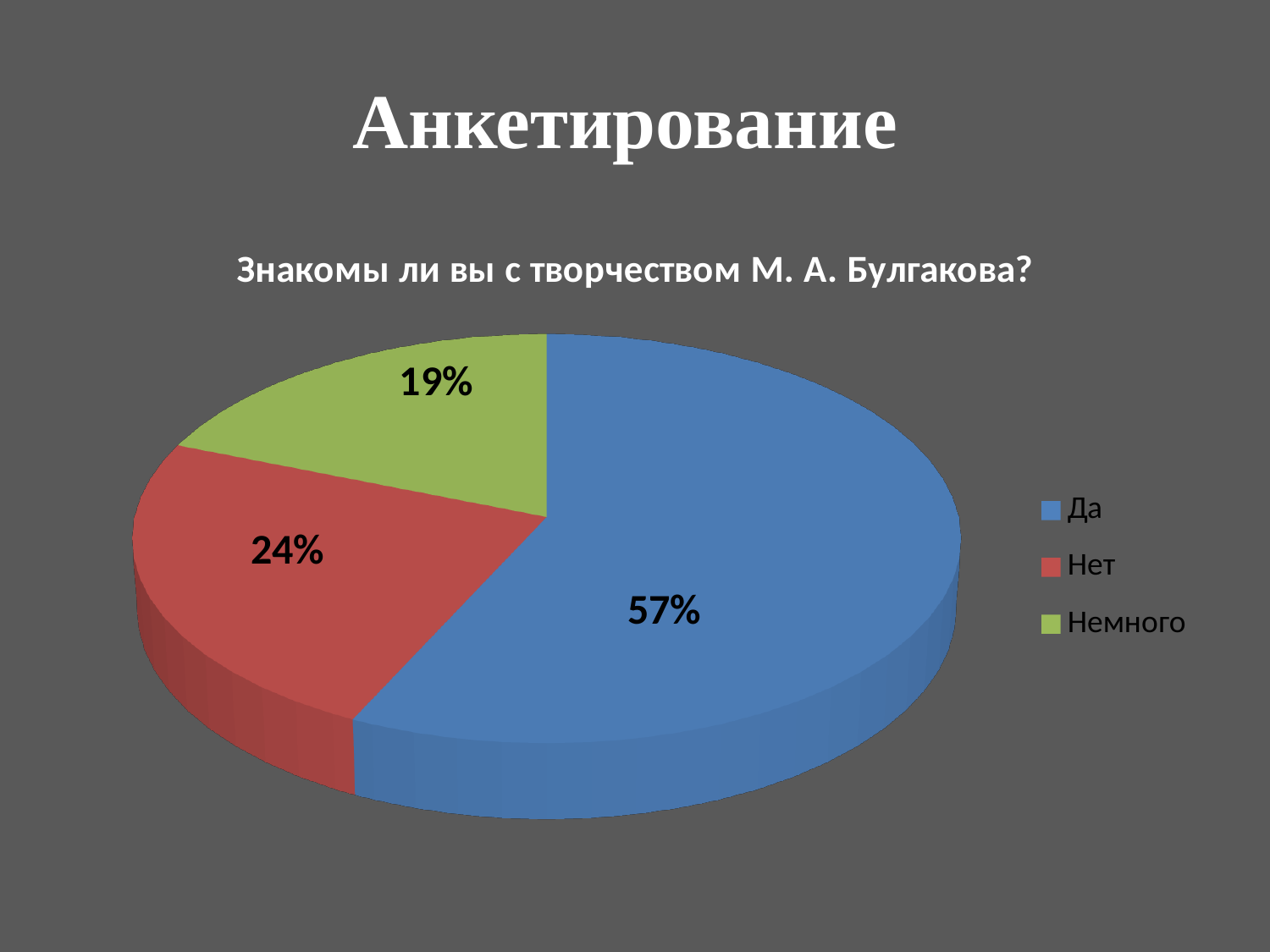
Which answer has the smallest share of the pie? Немного Which is larger, the share for "Нет" or the share for "Немного"? Нет What is the difference in percentage points between "Да" and "Нет"? 33 How many entries does the legend list? 3 How many slices does the pie chart have? 3 What colour is the slice for "Немного"? green What percentage of respondents answered "Немного"? 19% What percentage of respondents answered "Да"? 57% Which answer has the largest share of the pie? Да What percentage of respondents answered "Нет"? 24% What type of chart is shown on the slide? pie chart What is the title of the chart? Знакомы ли вы с творчеством М. А. Булгакова?